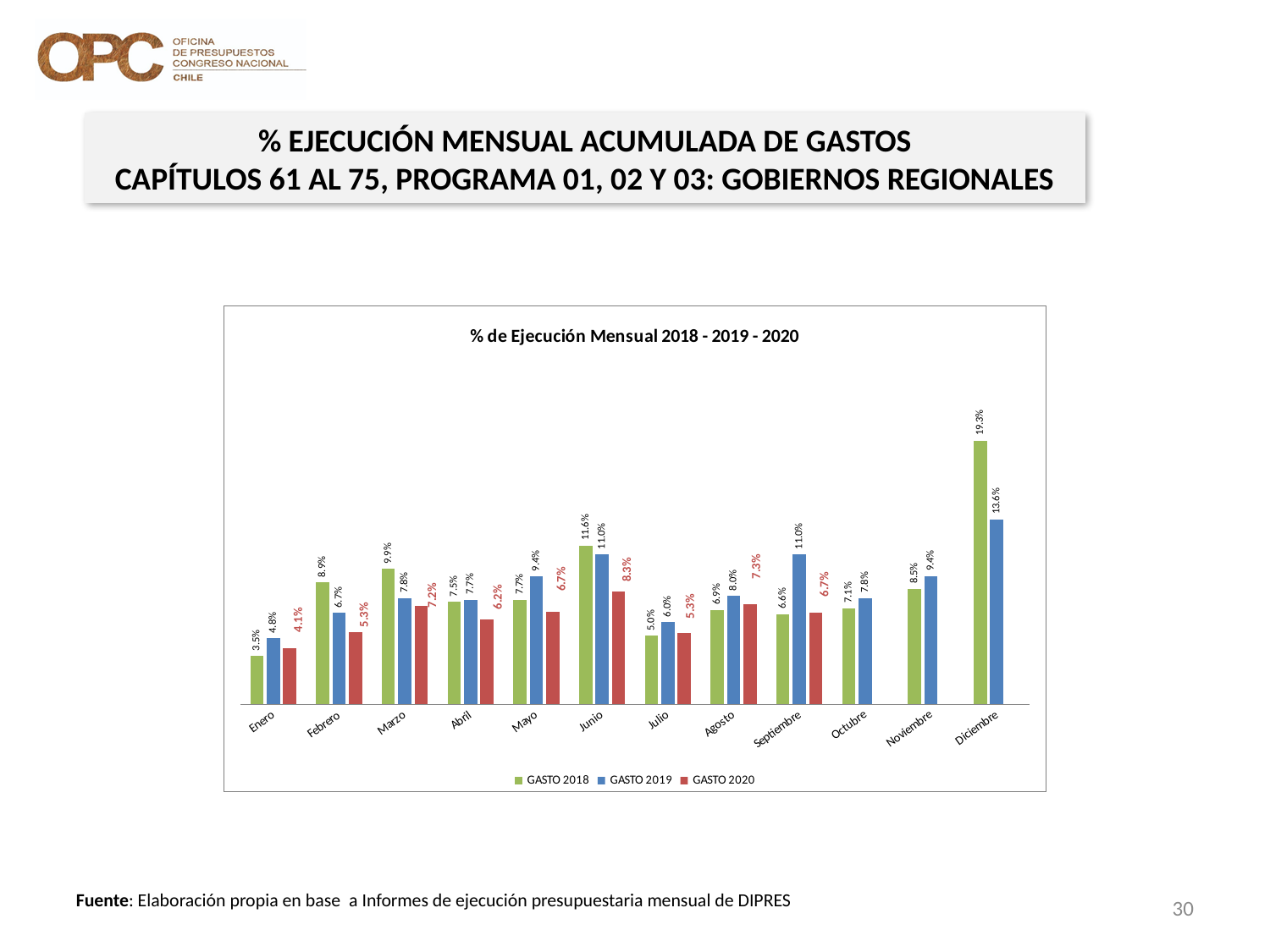
What kind of chart is shown? Bar chart What is the title of the chart? % de Ejecución Mensual 2018 - 2019 - 2020 Which month has the highest value for GASTO 2019? Diciembre What is the value for GASTO 2019 in Septiembre? 11.0% Which is larger in Febrero, GASTO 2018 or GASTO 2019? GASTO 2018 What is the difference between GASTO 2018 and GASTO 2019 in Diciembre? 5.7% Which month has the highest value for GASTO 2020? Junio Which month has the lowest value for GASTO 2018? Enero What is the value for GASTO 2020 in Junio? 8.3% What is the value for GASTO 2018 in Diciembre? 19.3% How many series does the legend list? 3 How many months are shown on the x axis? 12